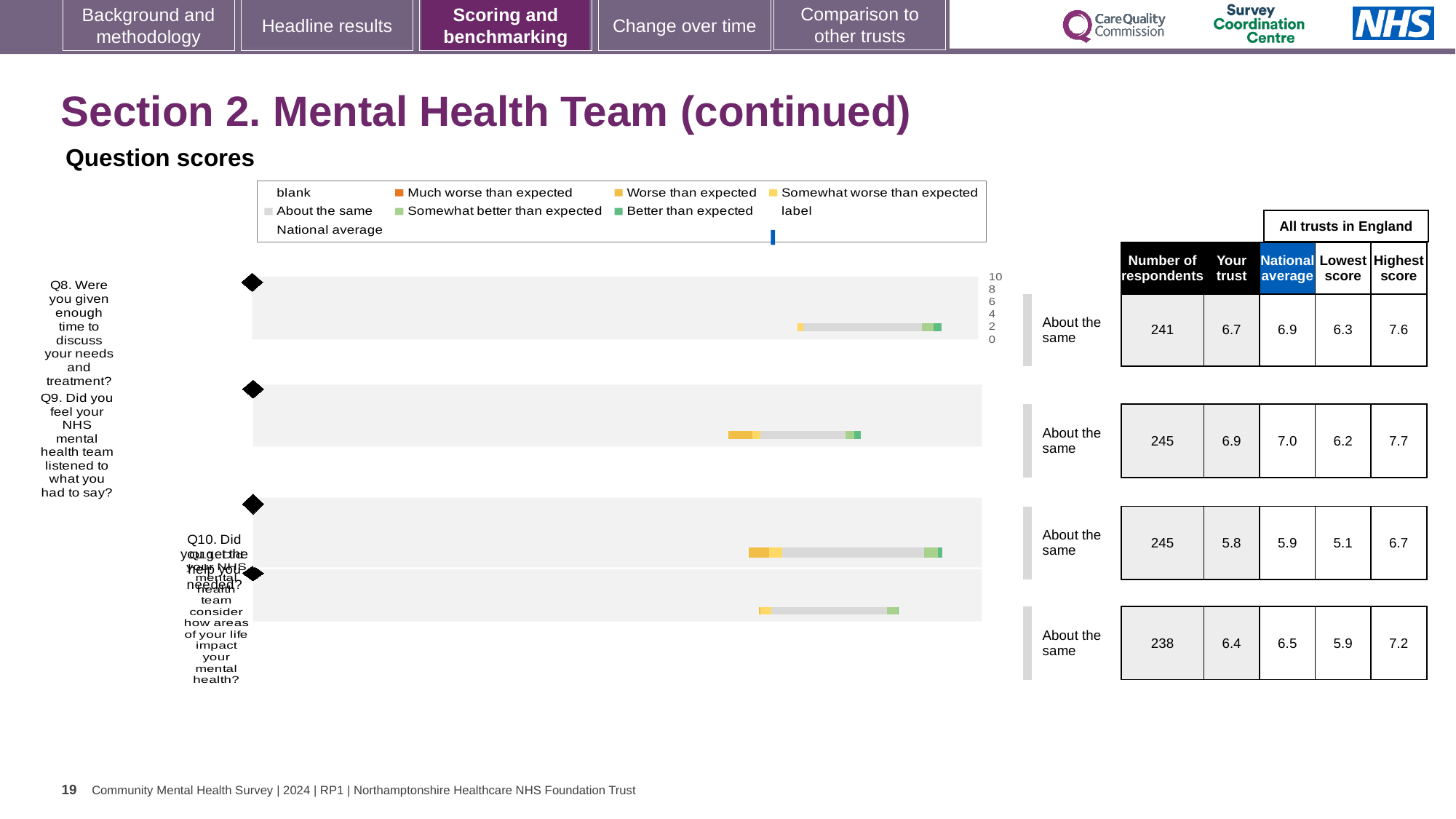
How many respondents answered Q11 (Did your NHS mental health team consider how areas of your life impact your mental health?)? 238 What is the 'Your trust' score for Q8 (Were you given enough time to discuss your needs and treatment?)? 6.7 Which question has the highest 'Your trust' score? Q9 What is the highest score among all trusts in England for Q10 (Did you get the help you needed?)? 6.7 What is the national average score for Q9 (Did you feel your NHS mental health team listened to what you had to say?)? 7.0 What is the lowest score among all trusts in England for Q11? 5.9 How many questions (bars) are plotted in the question scores chart? 4 What benchmark category is shown for Q10 (Did you get the help you needed?)? About the same Which question has the lowest 'Your trust' score? Q10 What kind of chart is used to show the question scores on this slide? bar chart For Q8, which is larger: the 'Your trust' score or the national average? National average What is the difference between the highest score and the lowest score for Q8? 1.3